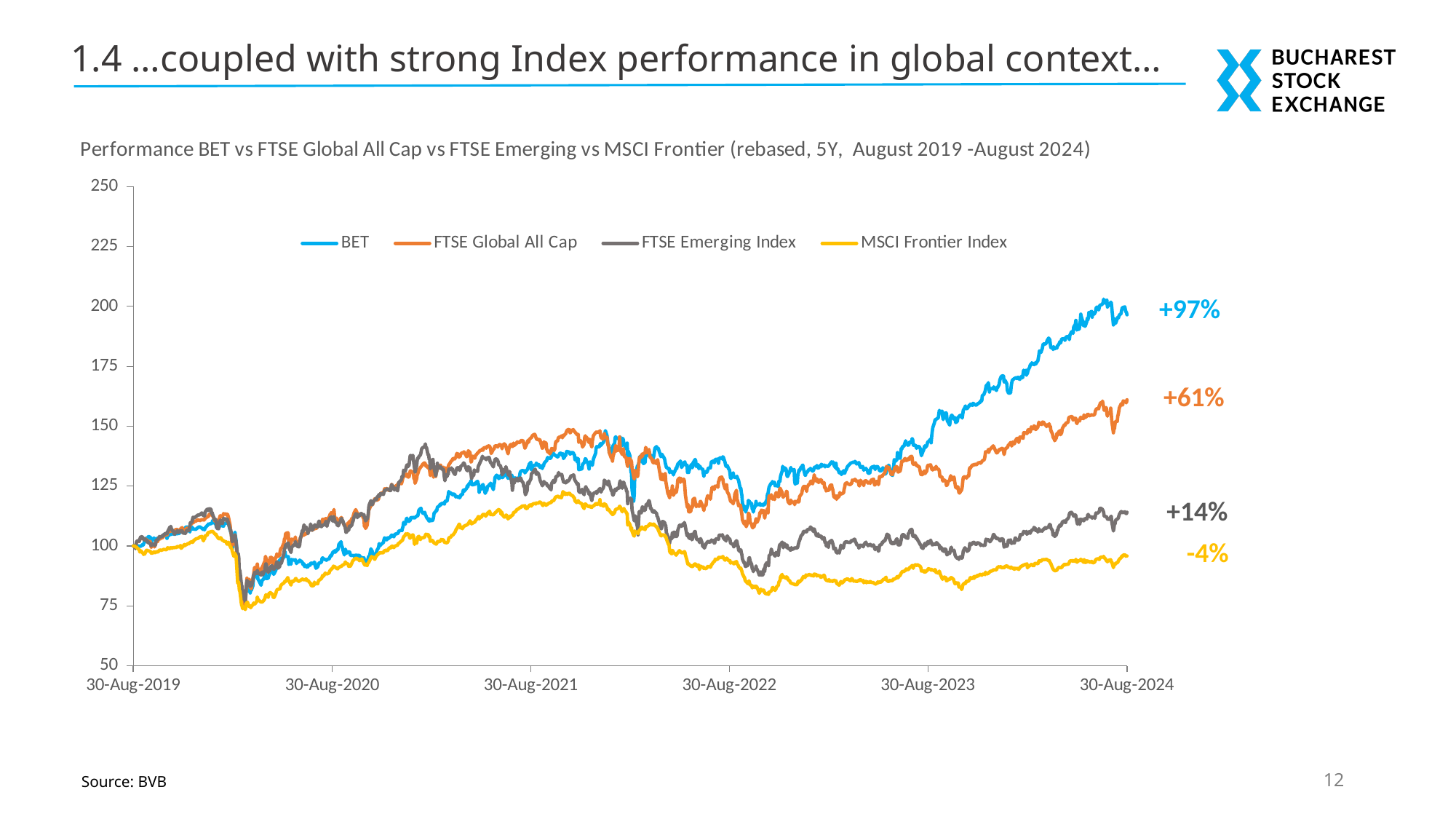
Is the BET line at 30-Aug-2024 greater or less than 175? greater What is the difference between the performance figures for BET and FTSE Global All Cap? 36 percentage points What is the 5-year performance figure shown for the MSCI Frontier Index? -4% How many series does the legend list? 4 What kind of chart is shown on the slide? line chart What is the 5-year performance figure shown for FTSE Global All Cap? +61% Which index has the highest 5-year performance figure? BET Is the MSCI Frontier Index line at 30-Aug-2024 greater or less than 100? less Which colour is used for the BET line? blue What is the 5-year performance figure shown for BET? +97% Which index has the lowest 5-year performance figure? MSCI Frontier Index What is the 5-year performance figure shown for the FTSE Emerging Index? +14%